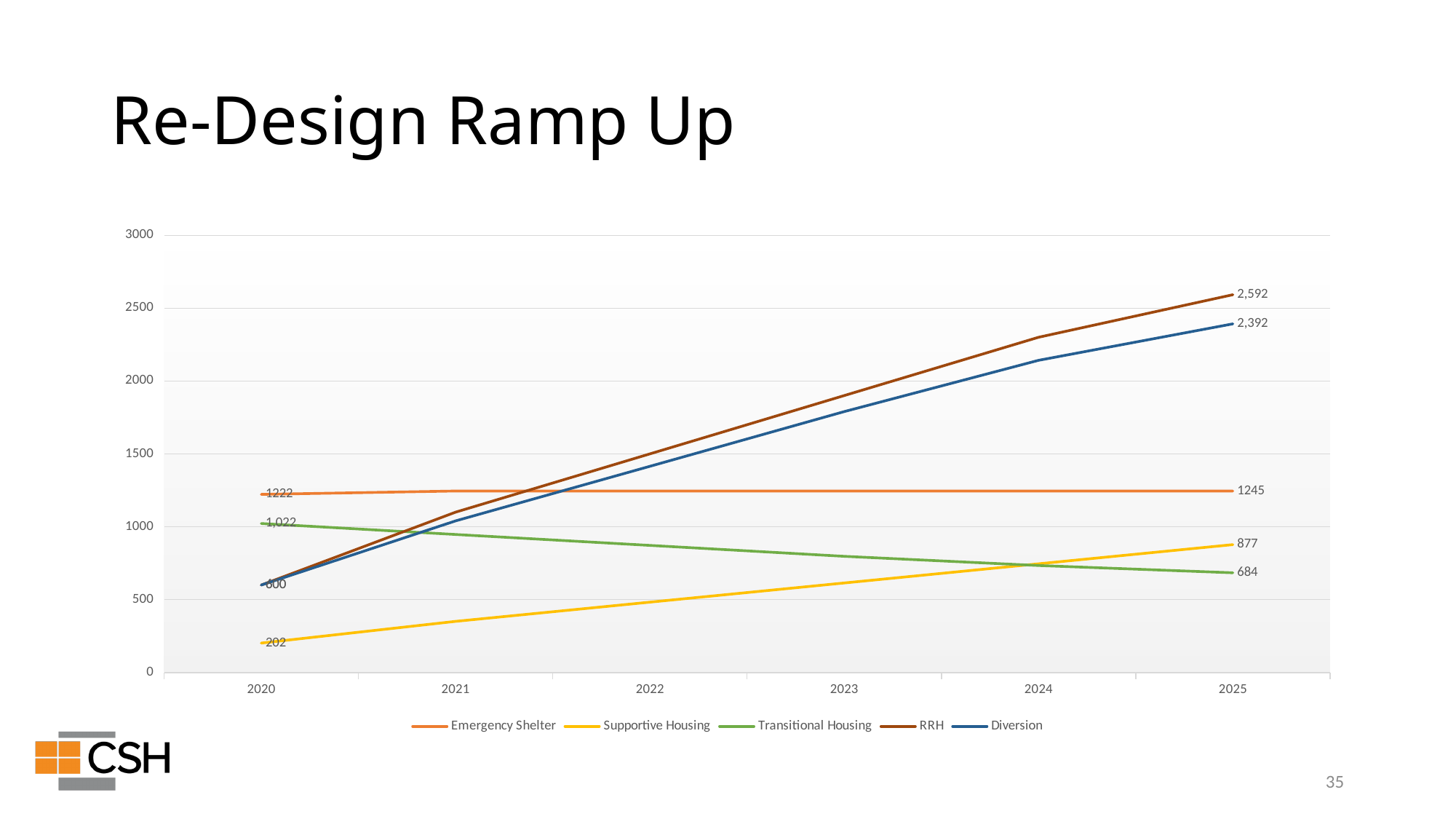
What is the value for Transitional Housing in 2020? 1,022 What type of chart is shown on the slide? line chart Which series has the highest value in 2025? RRH How many series does the legend list? 5 What is the value for Supportive Housing in 2025? 877 Which series has the lowest value in 2020? Supportive Housing What is the value for Emergency Shelter in 2020? 1222 What is the difference between the RRH and Diversion values in 2025? 200 What is the value for RRH in 2025? 2,592 Does the Transitional Housing line rise or fall from 2020 to 2025? fall Is the value for RRH in 2023 greater or less than 1500? greater What is the value for Diversion in 2025? 2,392